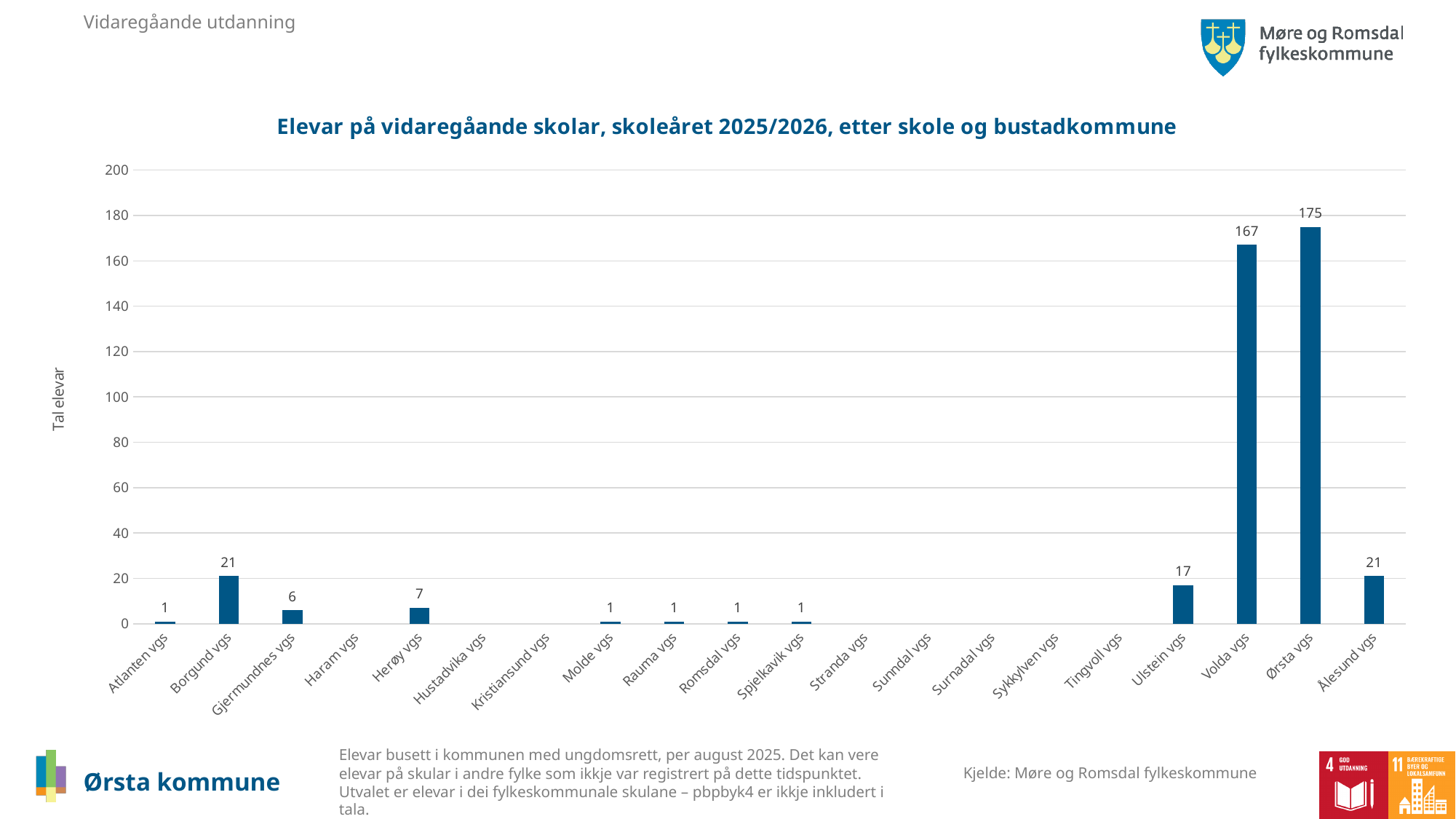
Which school has the highest number of students? Ørsta vgs What is the value for Ulstein vgs? 17 What is the label of the y axis? Tal elevar Is the value for Volda vgs greater or less than 160? greater What is the value for Ørsta vgs? 175 What is the difference between the values for Borgund vgs and Gjermundnes vgs? 15 How many schools are listed on the x axis? 20 Which is larger, the value for Borgund vgs or the value for Ulstein vgs? Borgund vgs What is the difference between the values for Ørsta vgs and Volda vgs? 8 How many students are shown for Volda vgs? 167 What kind of chart is shown on the slide? Bar chart What is the value for Herøy vgs? 7